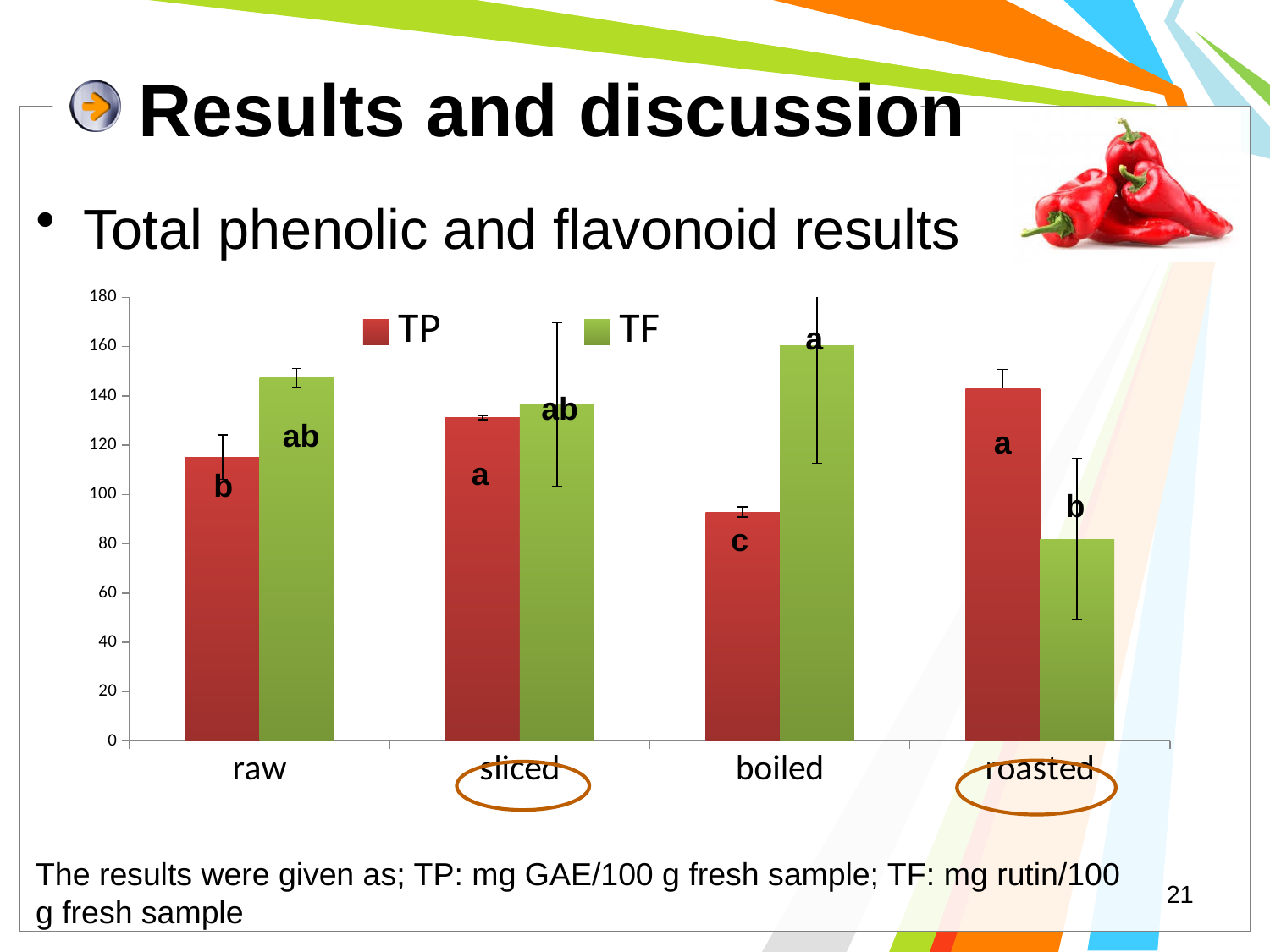
How many treatment categories are shown on the x axis? 4 Which category has the highest TF value? boiled For the roasted sample, which is larger, TP or TF? TP Which series is shown in red in the legend? TP Which category has the highest TP value? roasted How many series does the legend list? 2 Is the TF value for boiled greater or less than 140? greater For the raw sample, which is larger, TP or TF? TF What kind of chart is shown on the slide? bar chart Is the TP value for boiled greater or less than 100? less Which category has the lowest TF value? roasted Which category has the lowest TP value? boiled